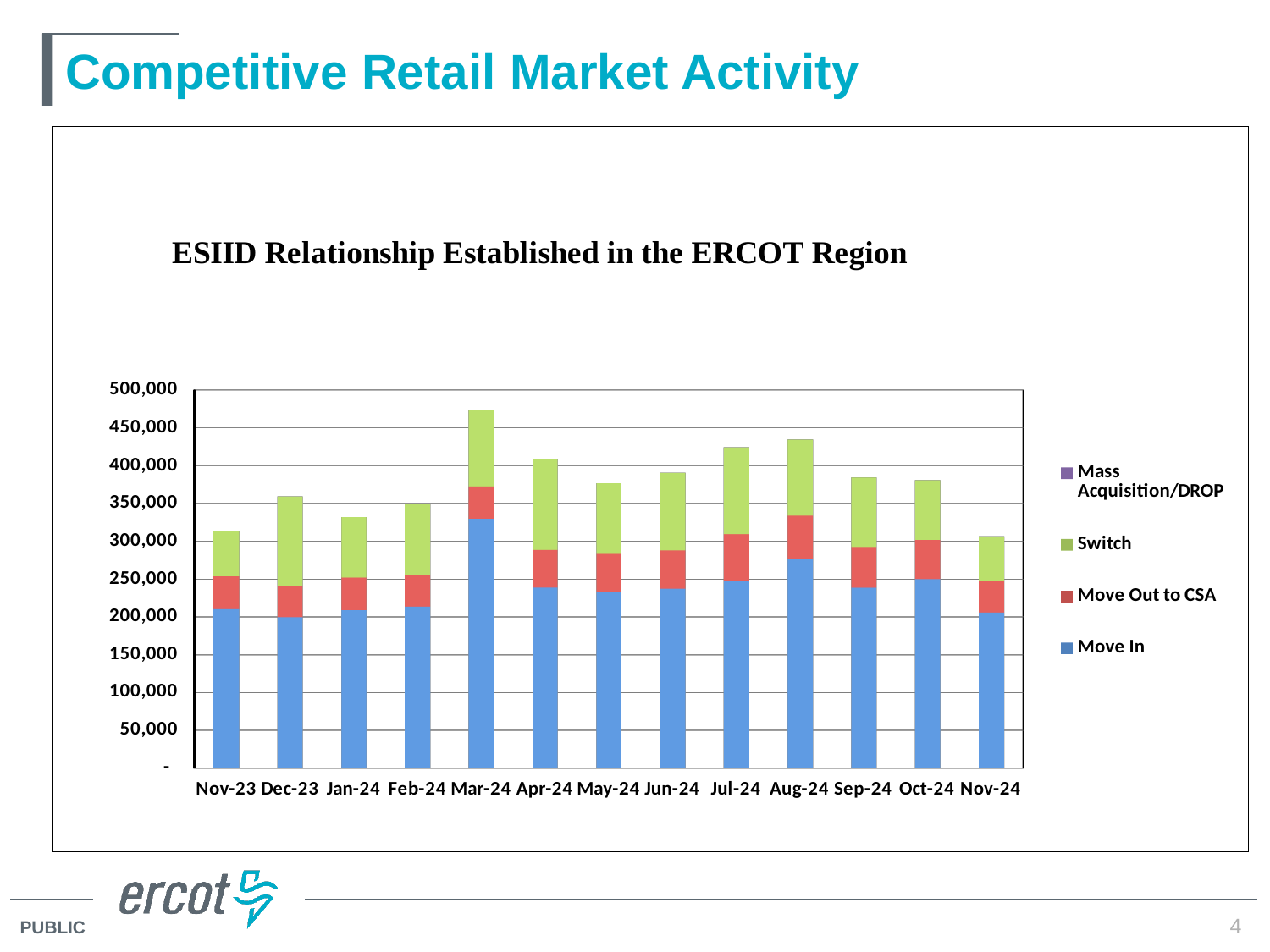
Is the total for Aug-24 greater or less than 400,000? greater What is the title of the chart? ESIID Relationship Established in the ERCOT Region Which month has the highest total bar? Mar-24 Do the total bars rise or fall from Mar-24 to May-24? fall Which has the larger total bar, Mar-24 or Aug-24? Mar-24 Is the total for Mar-24 greater or less than 450,000? greater Is the Move In value for Mar-24 greater or less than 300,000? greater Which series is shown in green in the legend? Switch How many months are shown on the x axis? 13 What kind of chart is shown on the slide? stacked bar chart How many series does the legend list? 4